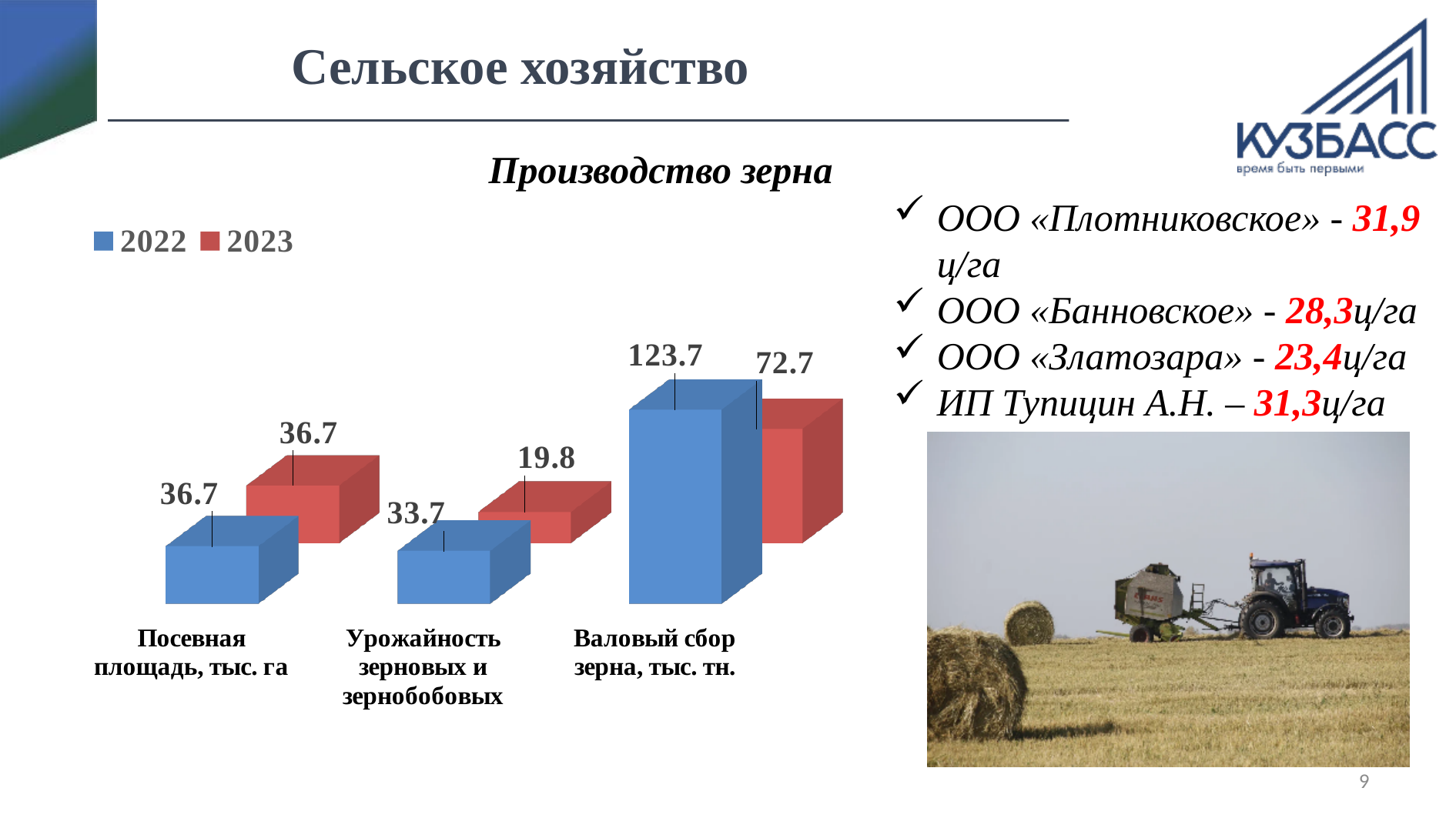
What is the 2022 value for Валовый сбор зерна, тыс. тн.? 123.7 How many series does the chart legend list? 2 What type of chart is shown on the slide? bar chart What is the difference between the 2022 and 2023 values for Валовый сбор зерна, тыс. тн.? 51.0 Which category has the highest 2022 value? Валовый сбор зерна, тыс. тн. How many categories are shown on the chart's x axis? 3 What is the 2023 value for Валовый сбор зерна, тыс. тн.? 72.7 What is the 2022 value for Посевная площадь, тыс. га? 36.7 What is the title of the chart on the slide? Производство зерна Which category has the lowest 2023 value? Урожайность зерновых и зернобобовых For Урожайность зерновых и зернобобовых, which year has the larger value, 2022 or 2023? 2022 What is the 2023 value for Урожайность зерновых и зернобобовых? 19.8